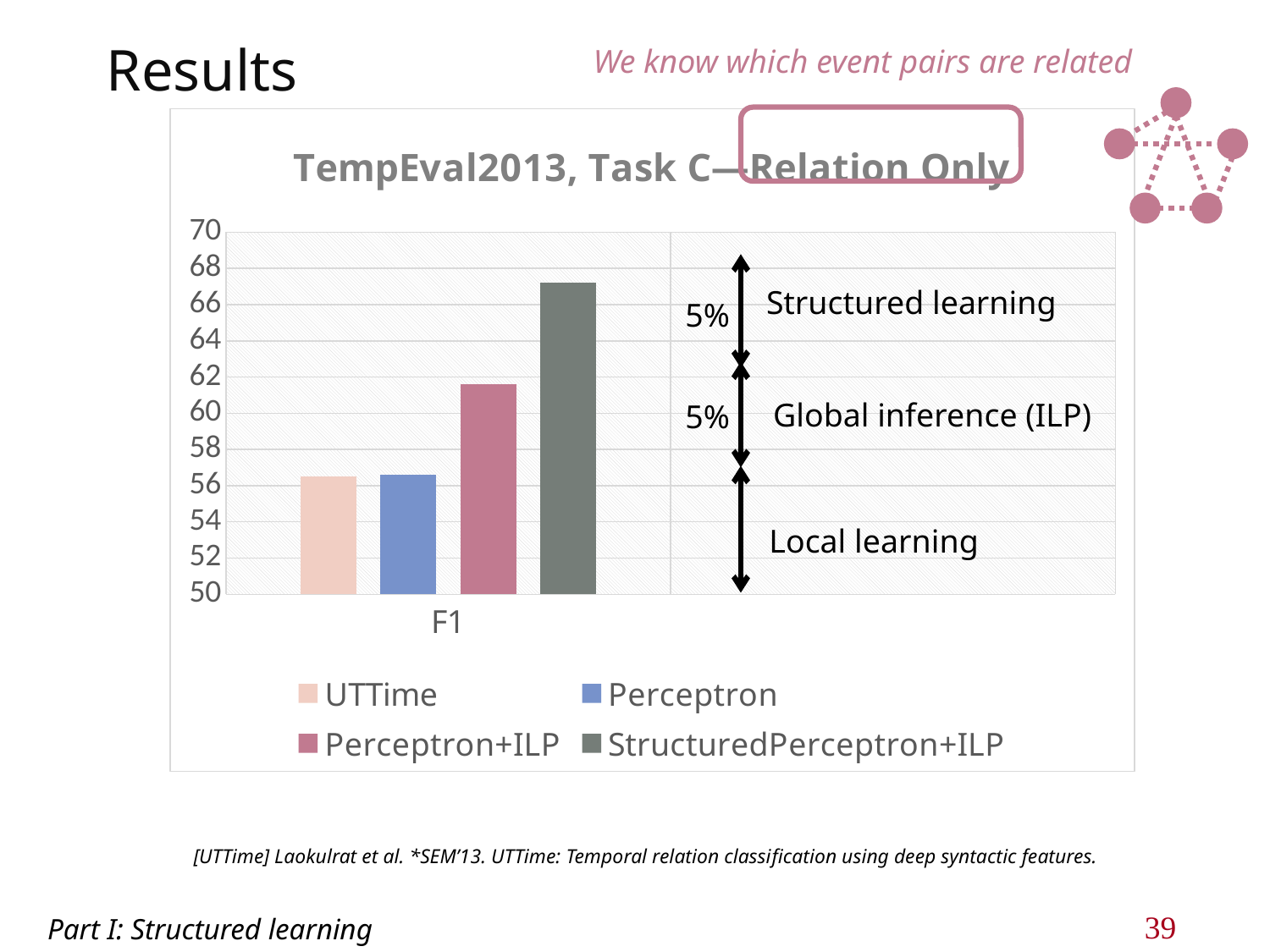
Which has a higher F1 value, Perceptron+ILP or Perceptron? Perceptron+ILP How many categories are shown on the x axis of the chart? 1 Is the F1 value for Perceptron+ILP greater or less than 60? greater What is the title of the chart? TempEval2013, Task C—Relation Only Is the F1 value for StructuredPerceptron+ILP greater or less than 66? greater Is the F1 value for UTTime greater or less than 58? less What is the label of the category on the x axis? F1 Which series has the highest F1 value in the chart? StructuredPerceptron+ILP What kind of chart is shown on the slide? bar chart Which has a higher F1 value, StructuredPerceptron+ILP or Perceptron+ILP? StructuredPerceptron+ILP How many series does the chart legend list? 4